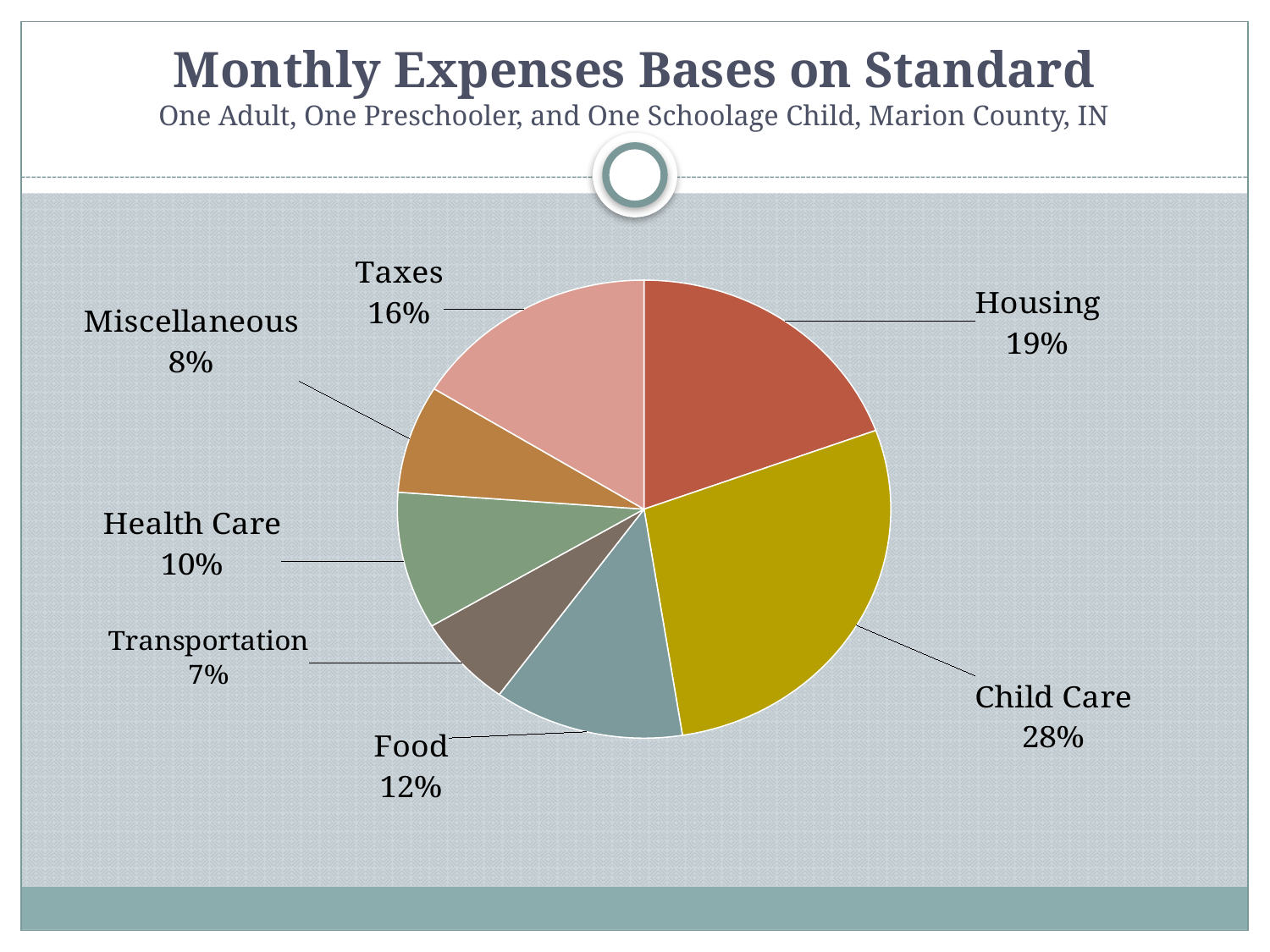
What is the difference in percentage points between Food and Miscellaneous? 4 What percentage of the pie is Housing? 19% What is the title of the chart on the slide? Monthly Expenses Bases on Standard Which category has the largest share of monthly expenses? Child Care Which is larger, Health Care or Taxes? Taxes What is the difference in percentage points between Child Care and Housing? 9 What percentage is shown for Transportation? 7% What share does Taxes represent? 16% Which category has the smallest share of monthly expenses? Transportation What type of chart is shown on the slide? Pie chart How many categories are shown in the pie chart? 7 What share of monthly expenses does Child Care account for? 28%